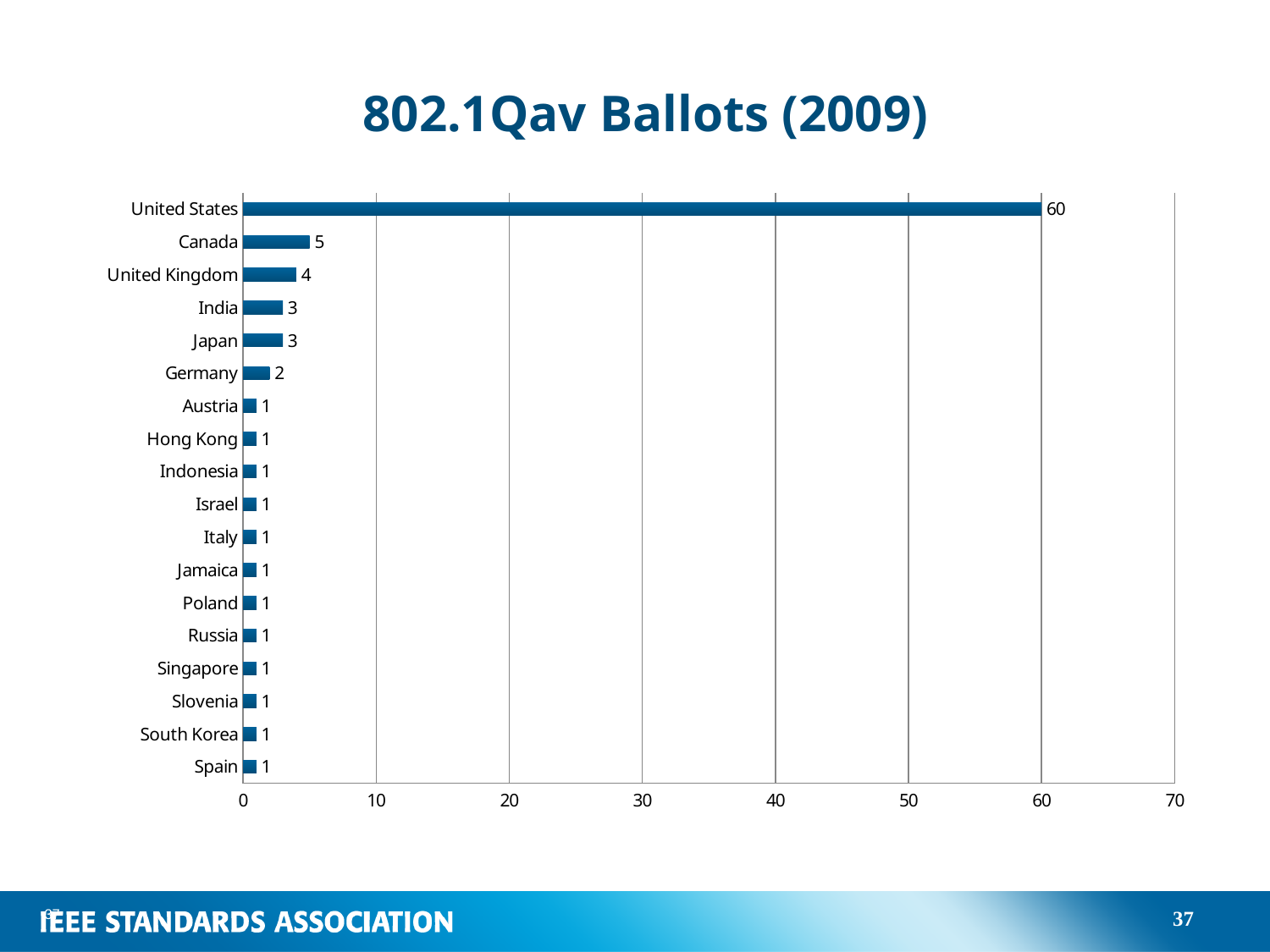
Which has a larger value, the United Kingdom or Japan? United Kingdom What is the value for Germany? 2 What is the value for the United States? 60 What is the difference between the values for Canada and India? 2 What is the difference between the values for the United States and Canada? 55 Is the value for the United States greater or less than 50? greater Which country has the highest value? United States What is the title of the chart? 802.1Qav Ballots (2009) What kind of chart is shown on the slide? Bar chart How many countries are shown in the chart? 18 What is the value for the United Kingdom? 4 What is the value for Canada? 5